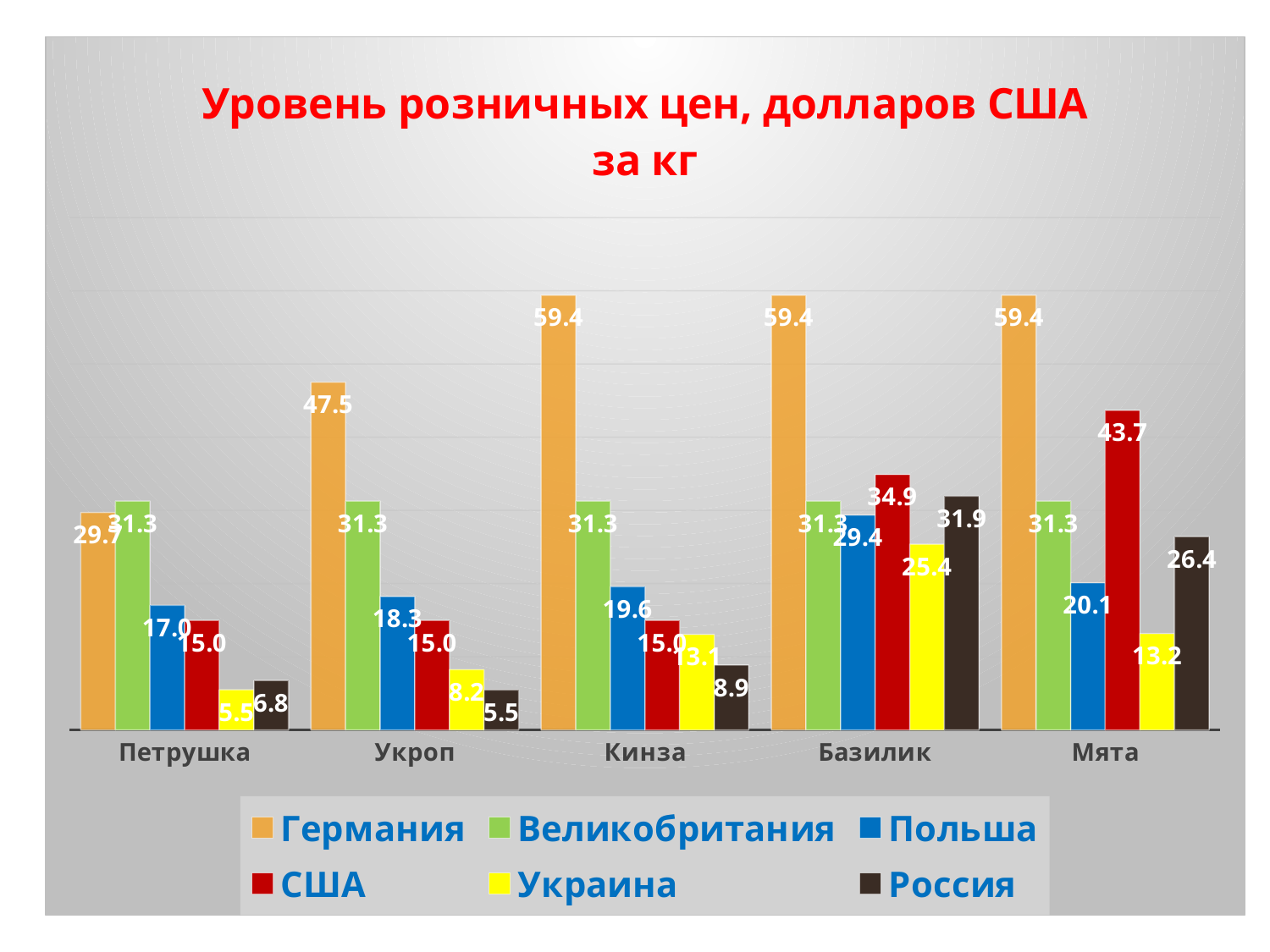
What is the retail price for Германия for Укроп? 47.5 What is the difference between the Германия and Великобритания values for Кинза? 28.1 Which country has the highest value for Базилик? Германия What kind of chart is shown on the slide? bar chart How many series does the legend list? 6 Which country has the lowest value for Укроп? Россия What is the value for Россия for Базилик? 31.9 What is the title of the chart? Уровень розничных цен, долларов США за кг Which is larger for Мята: the value for Польша or the value for Россия? Россия How many product categories are shown on the x axis? 5 What is the value for Украина for Петрушка? 5.5 What is the value for США for Мята? 43.7